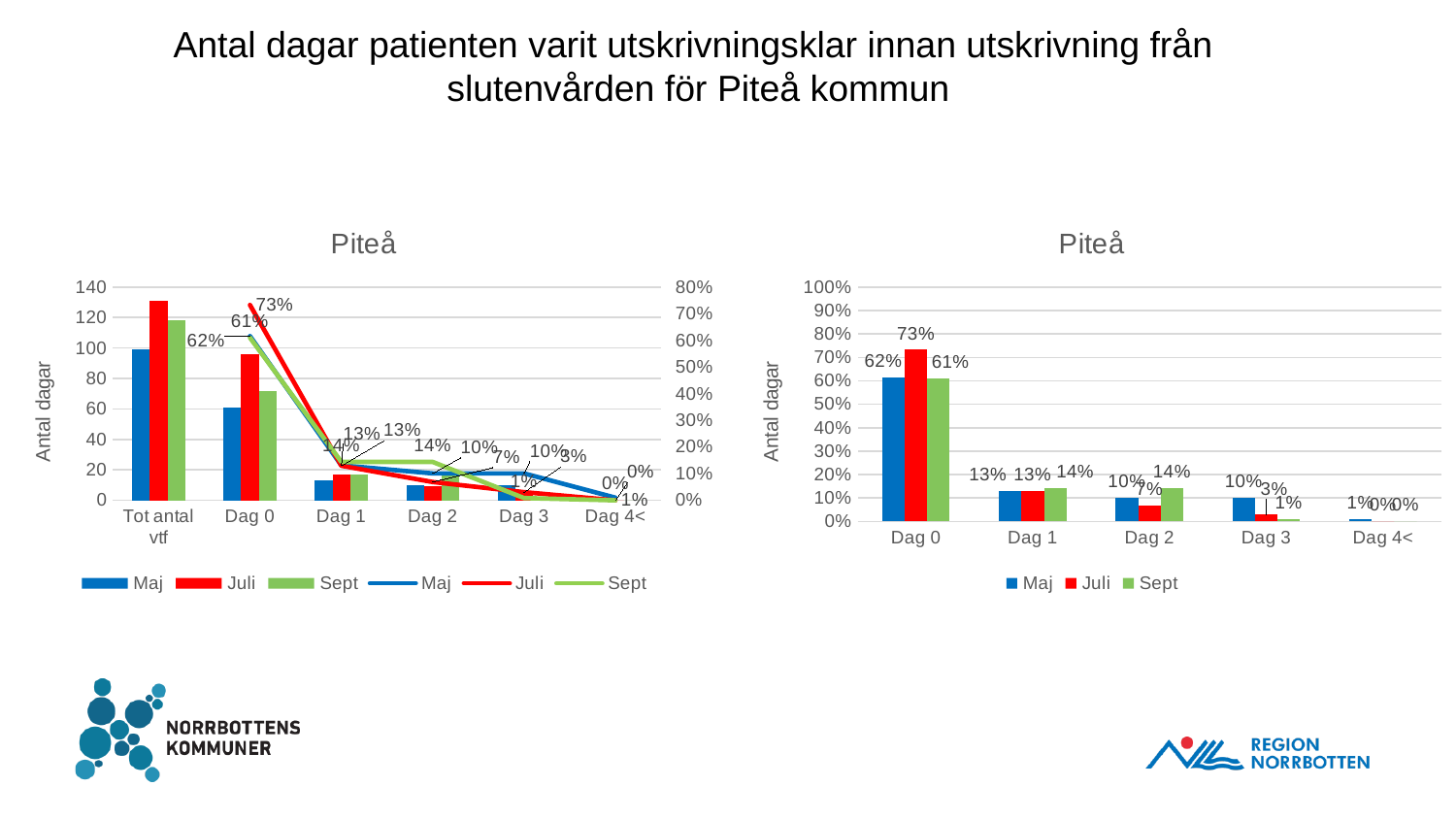
In the left chart, which month has the highest bar for Tot antal vtf? Juli What kind of chart is the right chart? Bar chart How many series does the legend of the right chart list? 3 In the left chart, is the Maj bar for Dag 0 greater or less than 80? less How many categories are shown on the x axis of the right chart? 5 In the right chart, what is the value for Juli at Dag 0? 73% In the right chart, what is the difference between the Juli and Sept values at Dag 0? 12 percentage points In the left chart, is the Juli bar for Tot antal vtf greater or less than 120? greater In the right chart, what is the value for Sept at Dag 2? 14% In the right chart, at Dag 2, which is larger: the Maj value or the Juli value? Maj In the right chart, which month has the highest value at Dag 0? Juli In the right chart, what is the value for Maj at Dag 3? 10%